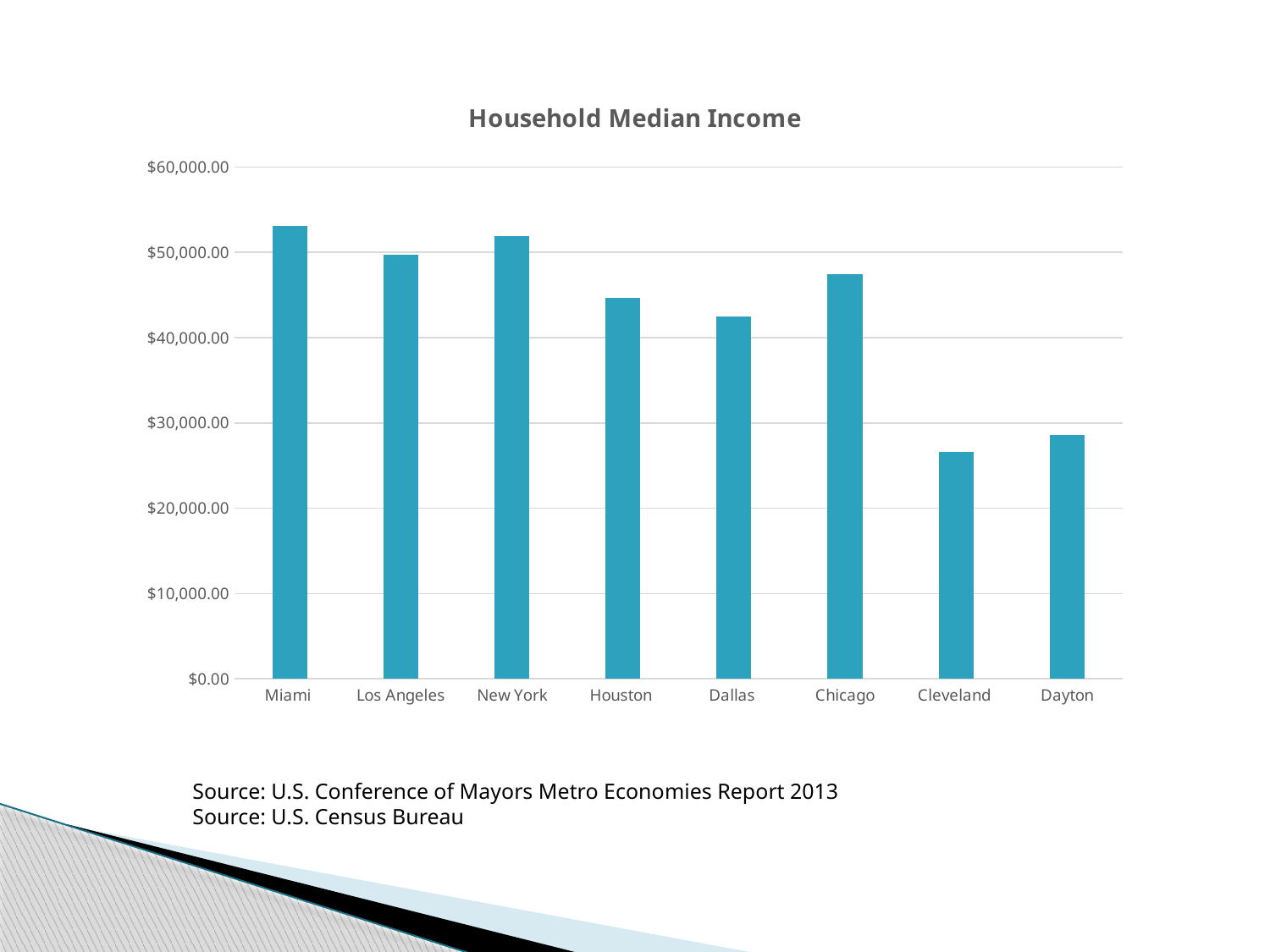
Which has a higher household median income, Dayton or Cleveland? Dayton Which has a higher household median income, Miami or Houston? Miami Is the value for Miami greater or less than $50,000.00? greater What is the title of the chart? Household Median Income How many cities are shown on the chart? 8 Is the value for Cleveland greater or less than $30,000.00? less Is the value for Dallas greater or less than $40,000.00? greater Which city has the lowest household median income? Cleveland Which has a higher household median income, Chicago or Dallas? Chicago What kind of chart is shown on the slide? Bar chart Which city has the highest household median income? Miami